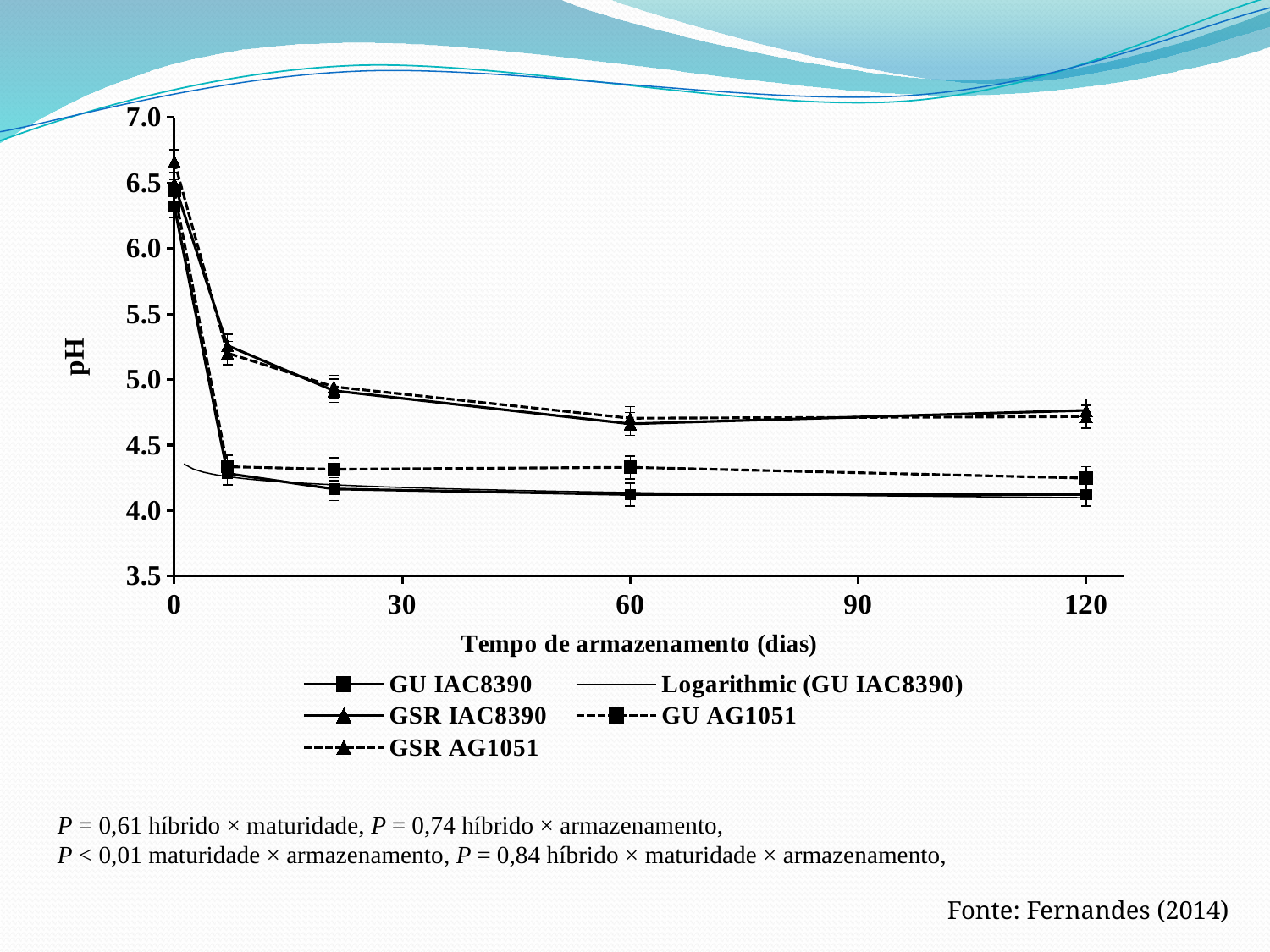
Does the pH of GU IAC8390 rise or fall from 0 to 120 days of storage? fall Is the pH value for GSR AG1051 at 0 days greater or less than 6.0? greater Is the pH value for GSR IAC8390 at 120 days greater or less than 4.5? greater Is the pH value for GU AG1051 at 60 days greater or less than 4.5? less At 60 days, which has the lower pH: GU AG1051 or GSR AG1051? GU AG1051 How many series does the legend list? 5 What is the label of the x axis? Tempo de armazenamento (dias) How many tick labels are shown on the x axis? 5 What kind of chart is shown on the slide? line chart At 120 days, which has the higher pH: GSR IAC8390 or GU IAC8390? GSR IAC8390 What is the label of the y axis? pH